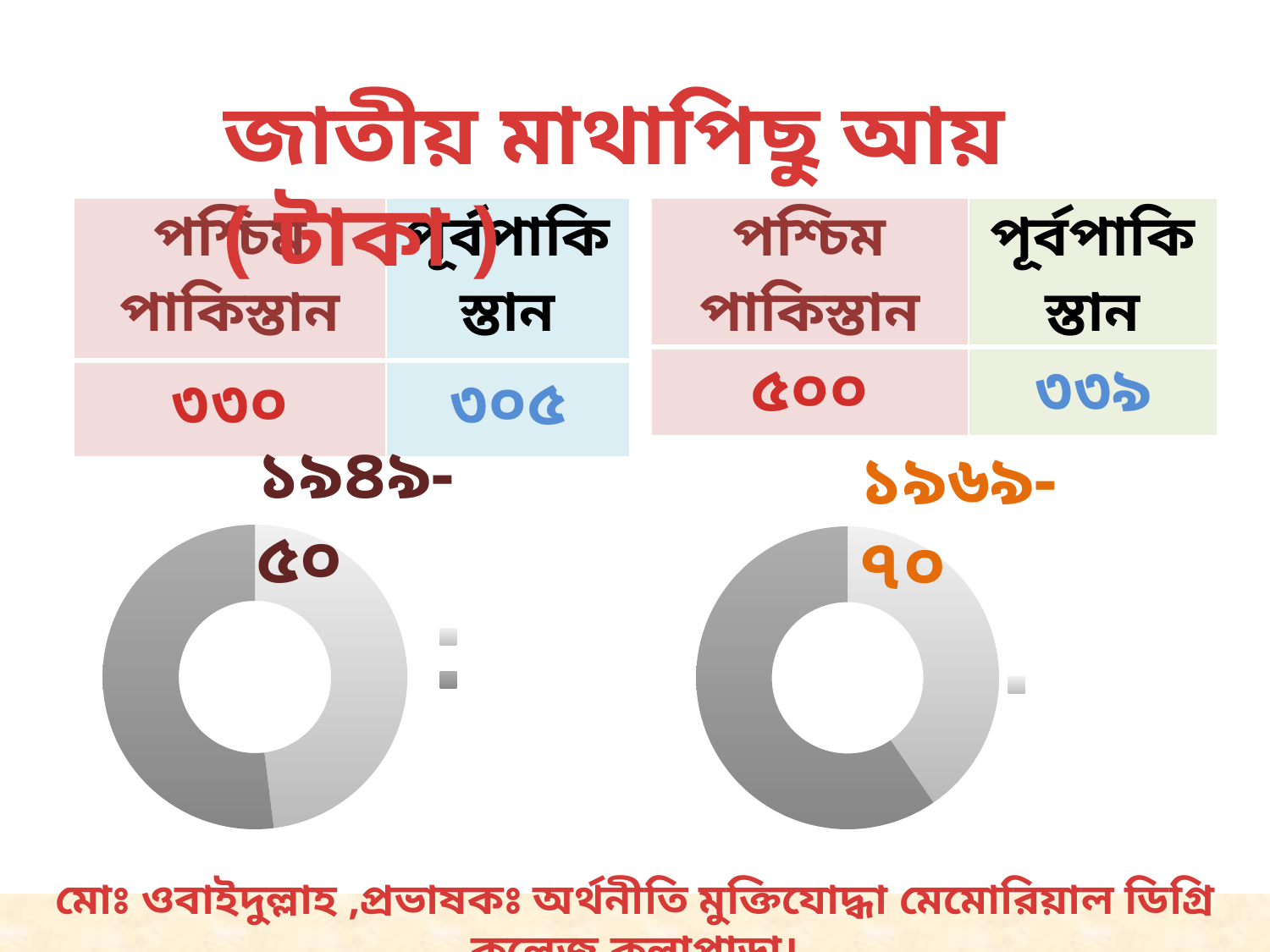
How many slices does the doughnut chart on the right side of the slide have? 2 What label appears above the doughnut chart on the right side of the slide? ১৯৬৯-৭০ How many slices does the doughnut chart on the left side of the slide have? 2 In the doughnut chart on the right side of the slide, which slice is larger, the dark grey slice or the light grey slice? the dark grey slice What kind of chart is the chart on the right side of the slide? doughnut chart What kind of chart is the chart on the left side of the slide? doughnut chart How many charts are shown on the slide? 2